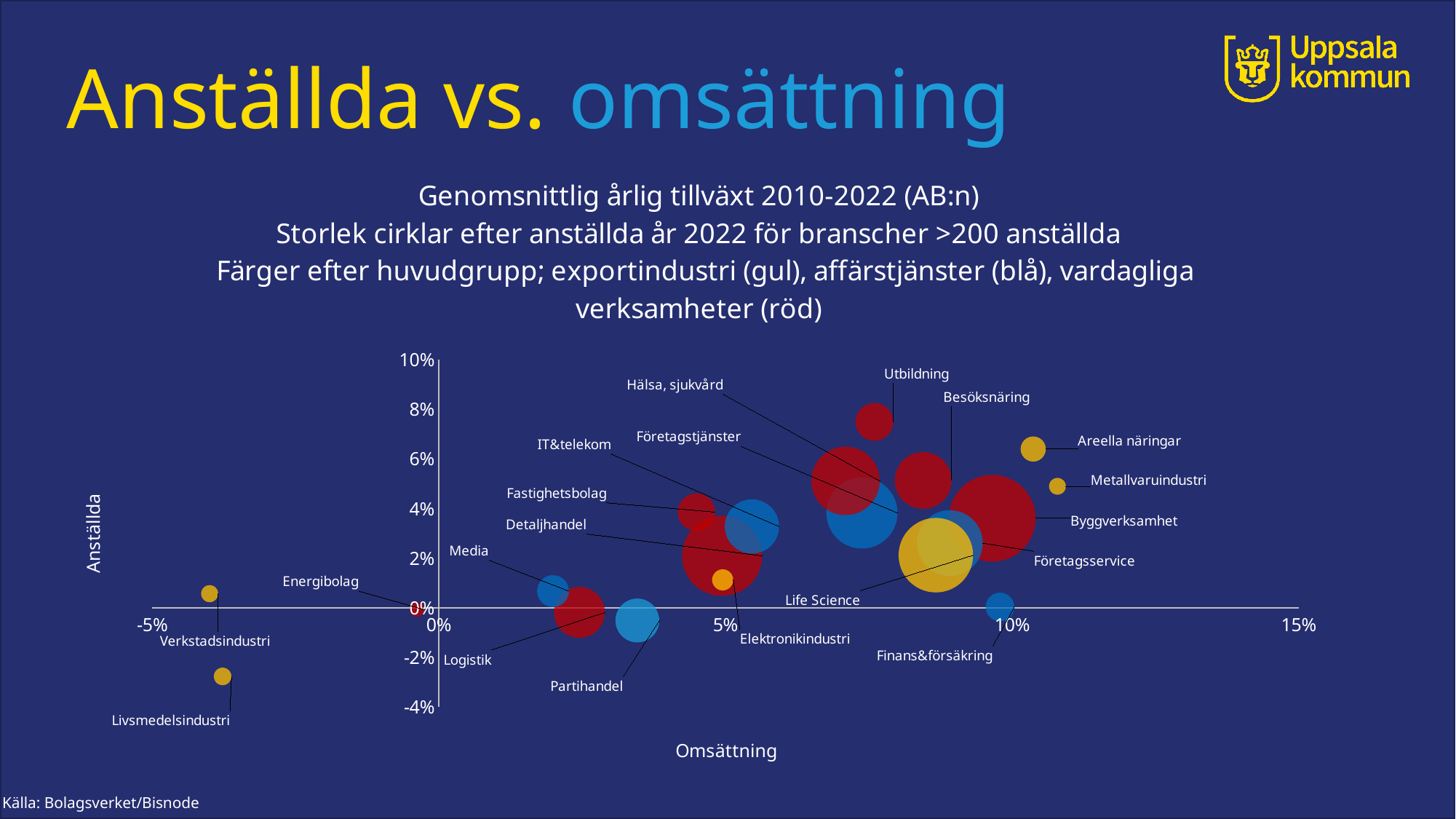
Which industry has the lowest Anställda growth in the chart? Livsmedelsindustri Is the Anställda value for Utbildning greater or less than 6%? greater What kind of chart is shown on the slide? bubble chart Is the Anställda value for Livsmedelsindustri greater or less than -2%? less Is the Omsättning value for Verkstadsindustri greater or less than 0%? less According to the subtitle, which colour is used for exportindustri? gul (yellow) What is the label of the horizontal axis of the chart? Omsättning Which has the higher Anställda growth, Utbildning or Partihandel? Utbildning Which industry has the highest Anställda growth in the chart? Utbildning How many labelled industries (bubbles) are plotted in the chart? 20